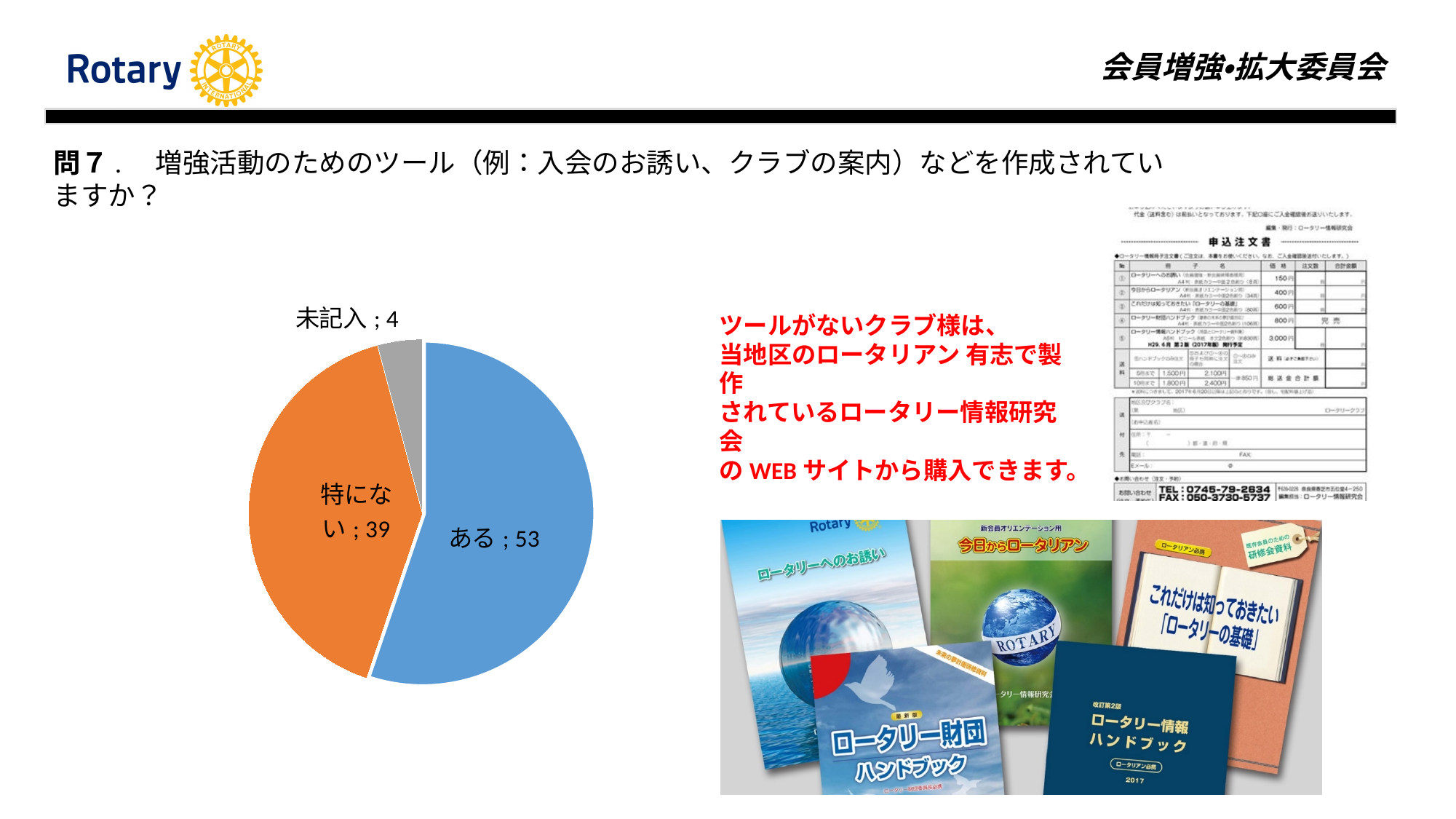
What is the difference between the values for ある and 特にない? 14 What is the value for 特にない in the pie chart? 39 What colour is the ある slice in the pie chart? blue What is the value for ある in the pie chart? 53 What is the total of all slices in the pie chart? 96 What is the value for 未記入 in the pie chart? 4 What type of chart is shown on the slide? pie chart How many slices does the pie chart have? 3 What share of the pie does the ある slice represent, to the nearest whole percent? 55% Which category has the smallest slice in the pie chart? 未記入 Which is larger, the value for 特にない or the value for 未記入? 特にない Which category has the largest slice in the pie chart? ある